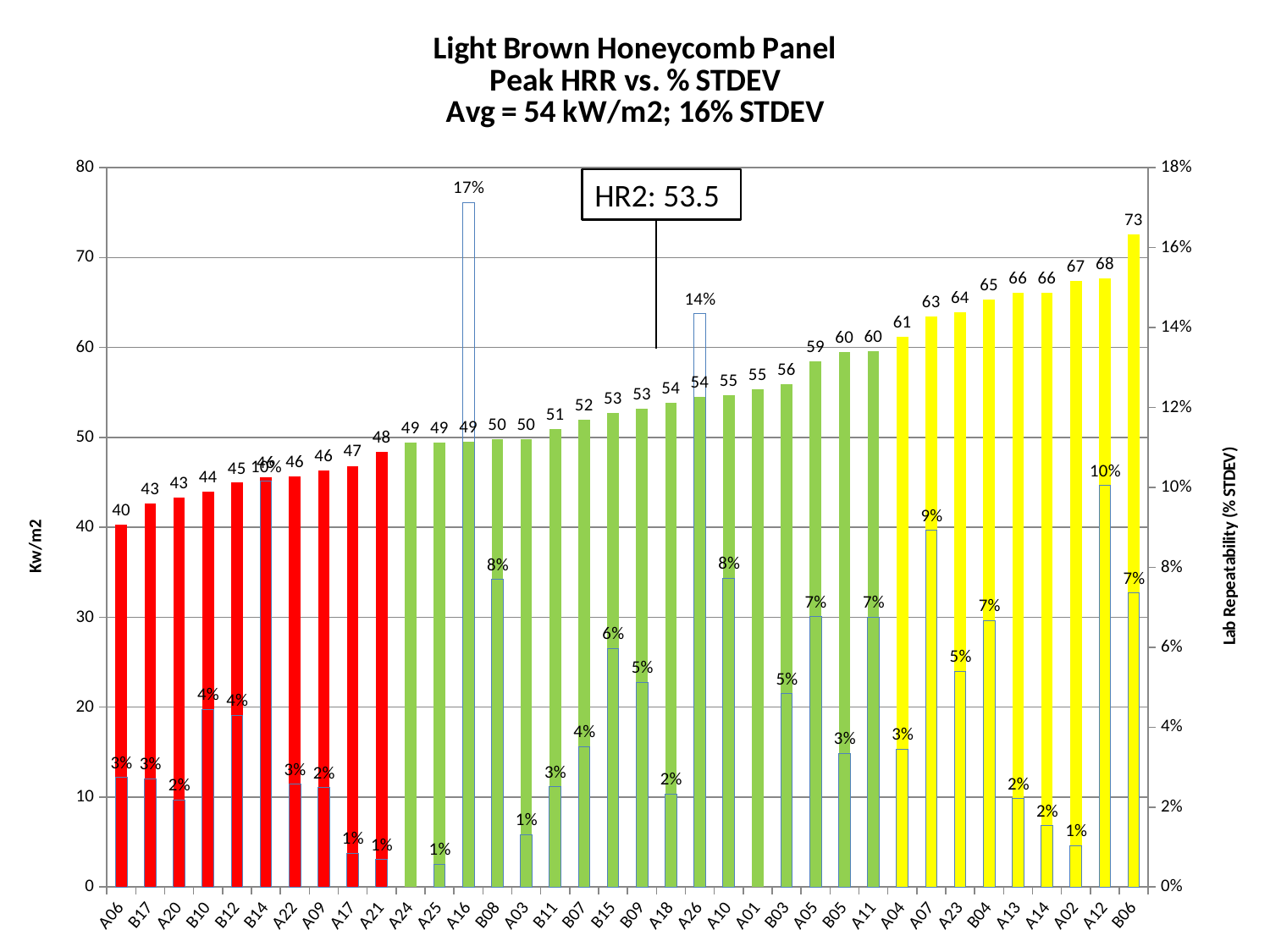
Which category has the highest peak HRR? B06 What is the difference in peak HRR between B06 and A06? 33 Which has the higher peak HRR, A07 or A04? A07 Which category has the lowest peak HRR? A06 What is the lab repeatability (% STDEV) value shown for A16? 17% What kind of chart is this? Bar chart What is the lab repeatability (% STDEV) value shown for A26? 14% Do the peak HRR values rise or fall from left to right along the x axis? Rise What average peak HRR is stated in the chart title? 54 kW/m2 Is the peak HRR value for A06 greater or less than 50? less How many categories are shown on the x axis? 36 What is the peak HRR value for B06? 73